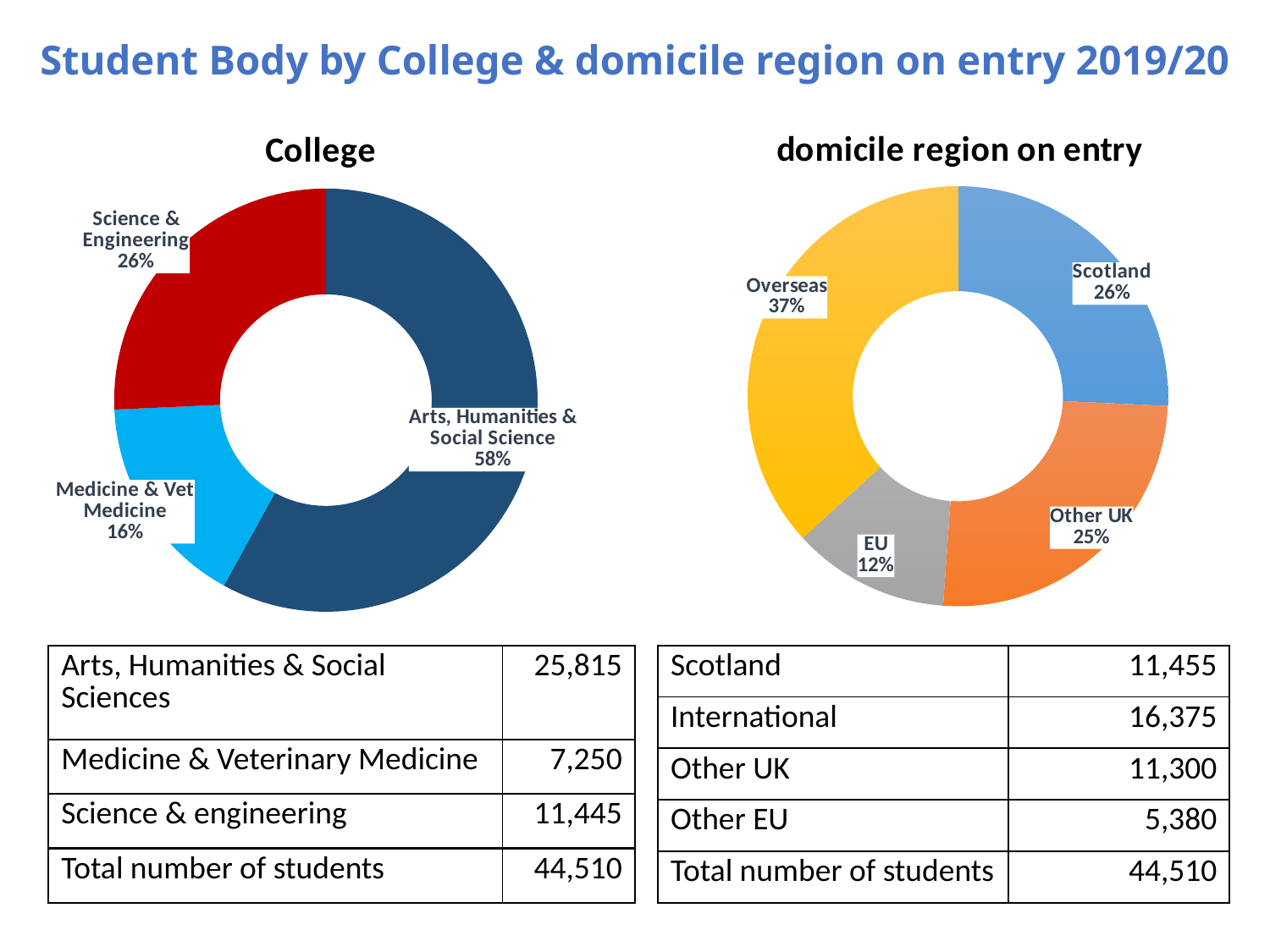
In the College chart, what share is Medicine & Vet Medicine? 16% In the domicile region on entry chart, which region has the largest share? Overseas In the College chart, which college has the largest share? Arts, Humanities & Social Science In the College chart, what is the difference in percentage points between Science & Engineering and Medicine & Vet Medicine? 10 In the College chart, which college has the smallest share? Medicine & Vet Medicine What kind of chart is the domicile region on entry chart? Donut (pie) chart In the College chart, what share of the student body is Arts, Humanities & Social Science? 58% How many categories does the College chart show? 3 In the domicile region on entry chart, which region has the smallest share? EU In the domicile region on entry chart, what is the difference in percentage points between Overseas and Other UK? 12 In the domicile region on entry chart, what share is EU? 12% In the domicile region on entry chart, what share is Overseas? 37%